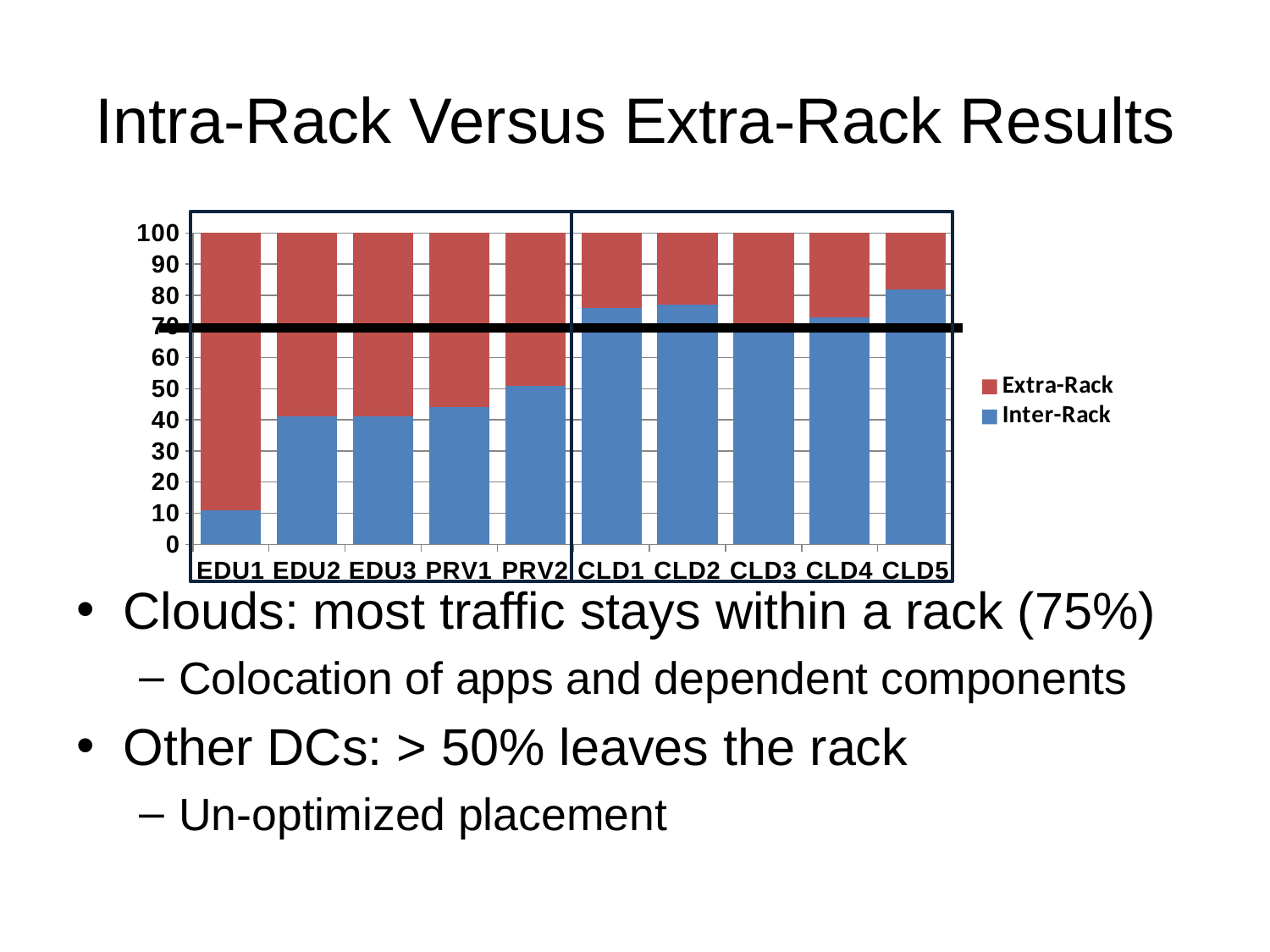
How many categories are shown along the x axis of the chart? 10 How many series does the chart's legend list? 2 Which has the larger Inter-Rack value, EDU1 or CLD5? CLD5 Which category has the largest Extra-Rack portion? EDU1 Is the Inter-Rack value for EDU2 greater or less than 50? less Which series is shown in red in the chart? Extra-Rack Which category has the highest Inter-Rack value? CLD5 What kind of chart is shown on the slide? Stacked bar chart Is the Inter-Rack value for EDU1 greater or less than 20? less Is the Inter-Rack value for CLD1 greater or less than 70? greater Which has the larger Inter-Rack value, PRV2 or EDU2? PRV2 Which category has the lowest Inter-Rack value? EDU1